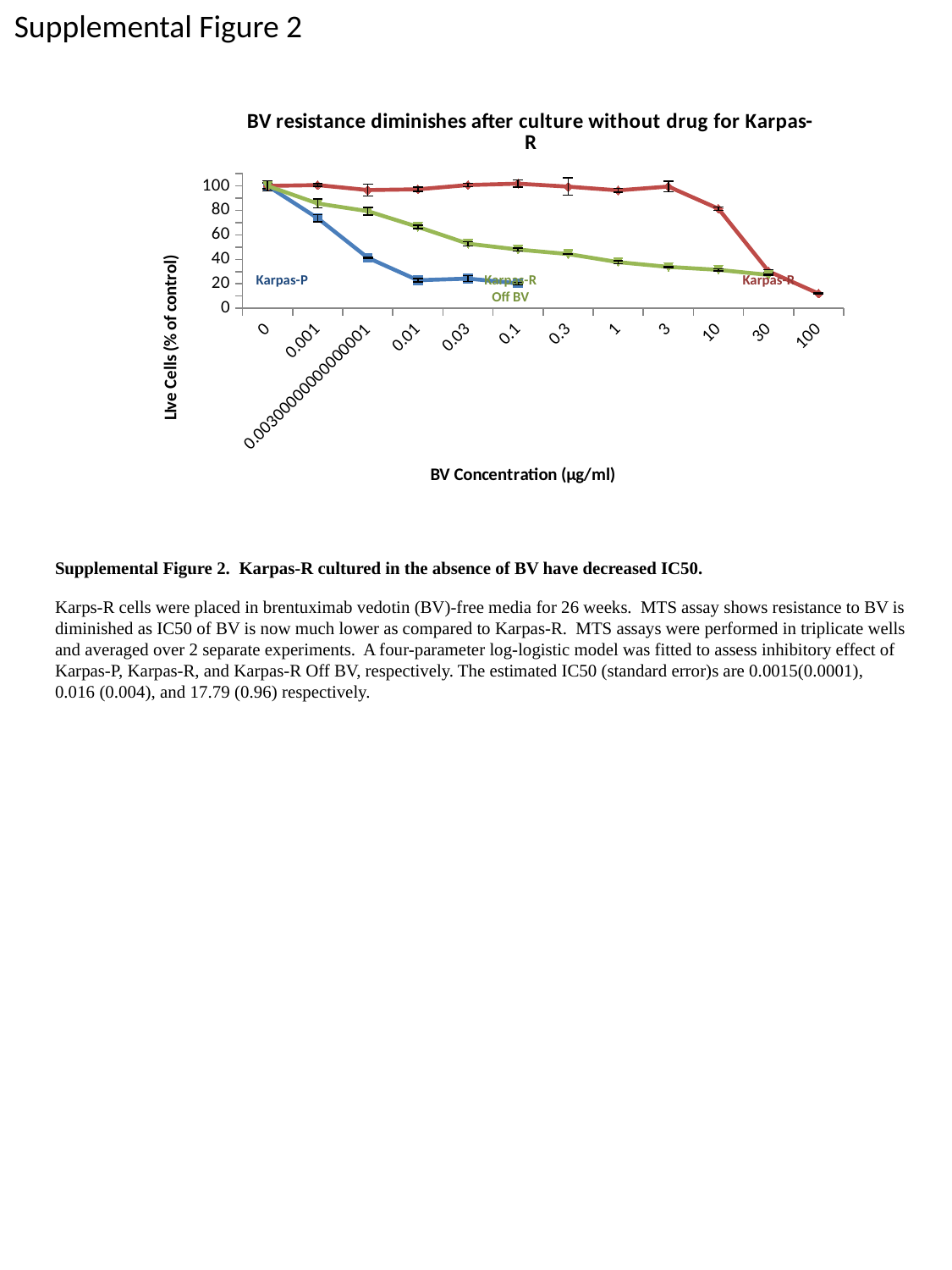
Is the value for Karpas-R Off BV at a BV concentration of 0.03 greater or less than 40? greater What is the label of the y axis? Live Cells (% of control) Is the value for Karpas-R at a BV concentration of 3 greater or less than 80? greater What kind of chart is shown on the slide? line chart How many BV concentration points are shown along the x axis? 12 Is the value for Karpas-P at a BV concentration of 0.01 greater or less than 40? less At a BV concentration of 0.01, which series has the higher value, Karpas-R or Karpas-P? Karpas-R What is the title of the chart? BV resistance diminishes after culture without drug for Karpas-R At a BV concentration of 0.1, which series has the lower value, Karpas-R Off BV or Karpas-R? Karpas-R Off BV Do the values for Karpas-P rise or fall as BV concentration increases from 0 to 0.01? fall How many series are plotted on the chart? 3